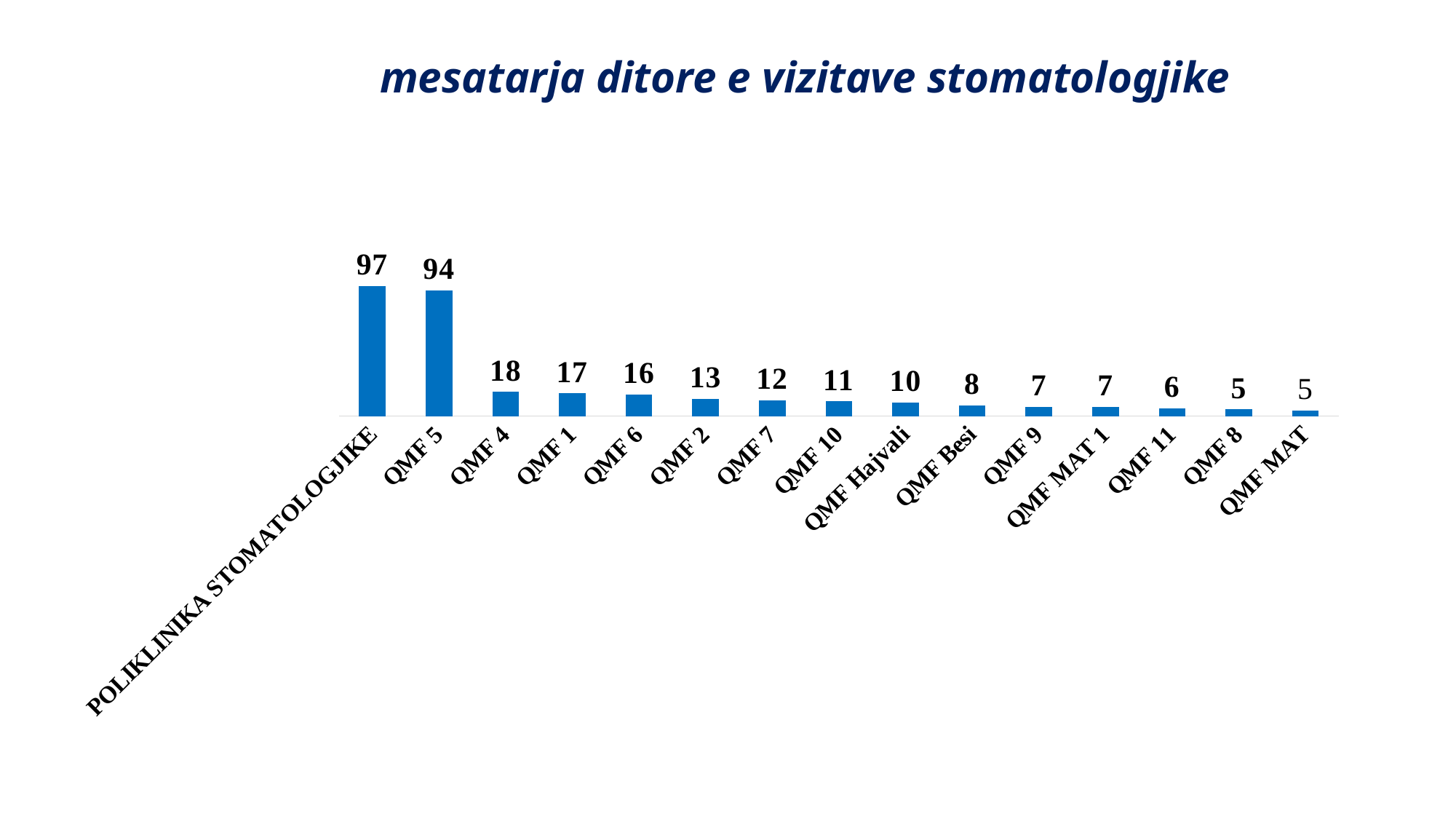
What is the value for QMF Hajvali? 10 Which category has the highest value? POLIKLINIKA STOMATOLOGJIKE What kind of chart is shown on the slide? Bar chart Which is larger, the value for QMF 6 or the value for QMF 7? QMF 6 What is the value for QMF MAT 1? 7 What is the title of the chart? mesatarja ditore e vizitave stomatologjike Which is larger, the value for QMF Besi or the value for QMF 10? QMF 10 How many categories are shown on the chart? 15 What is the difference between the values for QMF 4 and QMF 2? 5 Do the values rise or fall from left to right along the x axis? Fall What is the difference between the values for POLIKLINIKA STOMATOLOGJIKE and QMF 5? 3 What is the value for QMF 5? 94